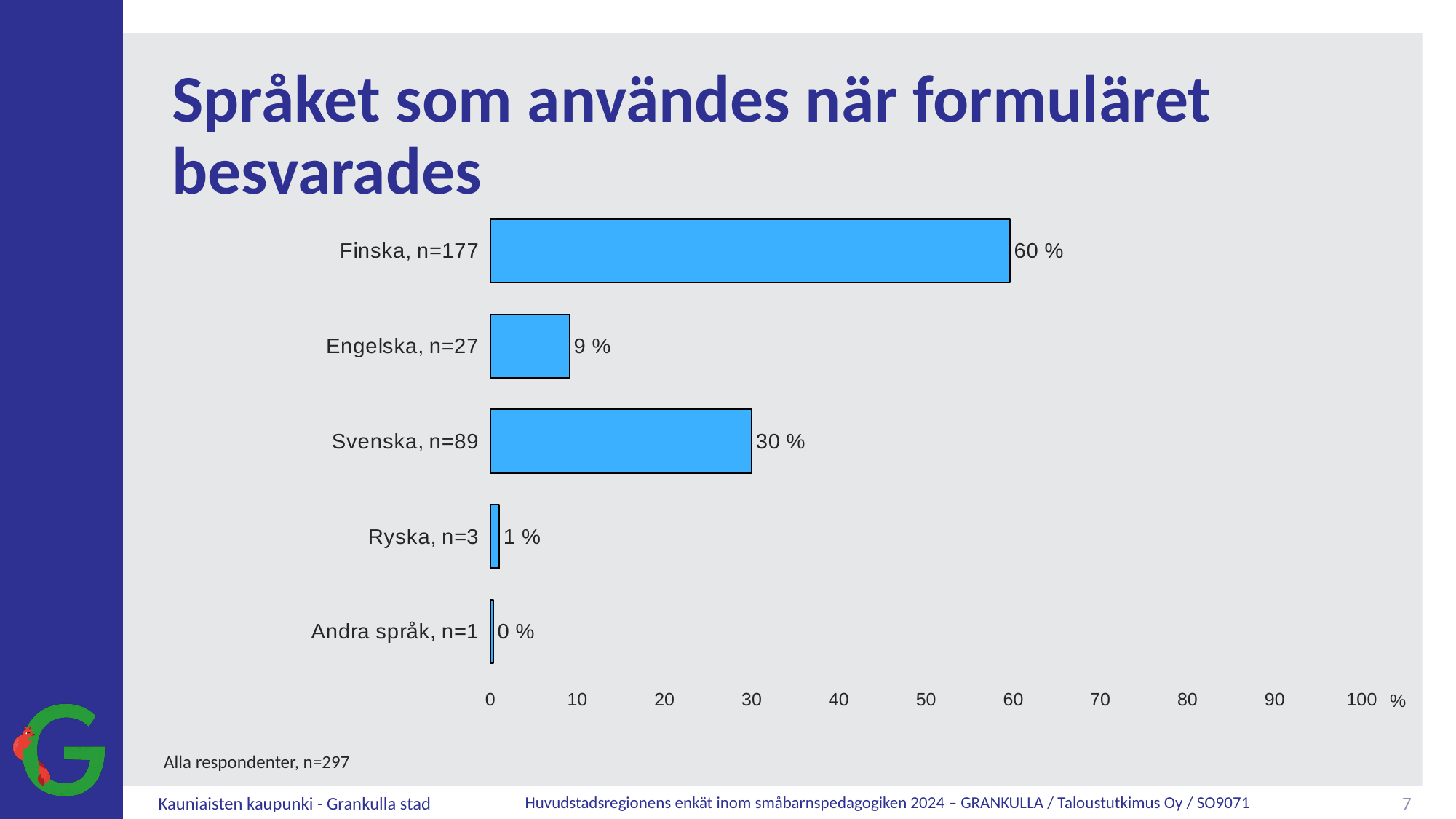
What percentage is shown for Ryska, n=3? 1 % What is the difference in percentage points between Finska and Svenska? 30 Which has a larger percentage, Engelska or Svenska? Svenska Is the value for Finska greater or less than 50? greater What kind of chart is shown on the slide? Bar chart What percentage is shown for Svenska, n=89? 30 % Which language category has the lowest percentage? Andra språk, n=1 What percentage is shown for Engelska, n=27? 9 % Which language category has the highest percentage? Finska, n=177 How many language categories are shown in the chart? 5 What is the total number of respondents stated below the chart? n=297 What percentage is shown for Finska, n=177? 60 %